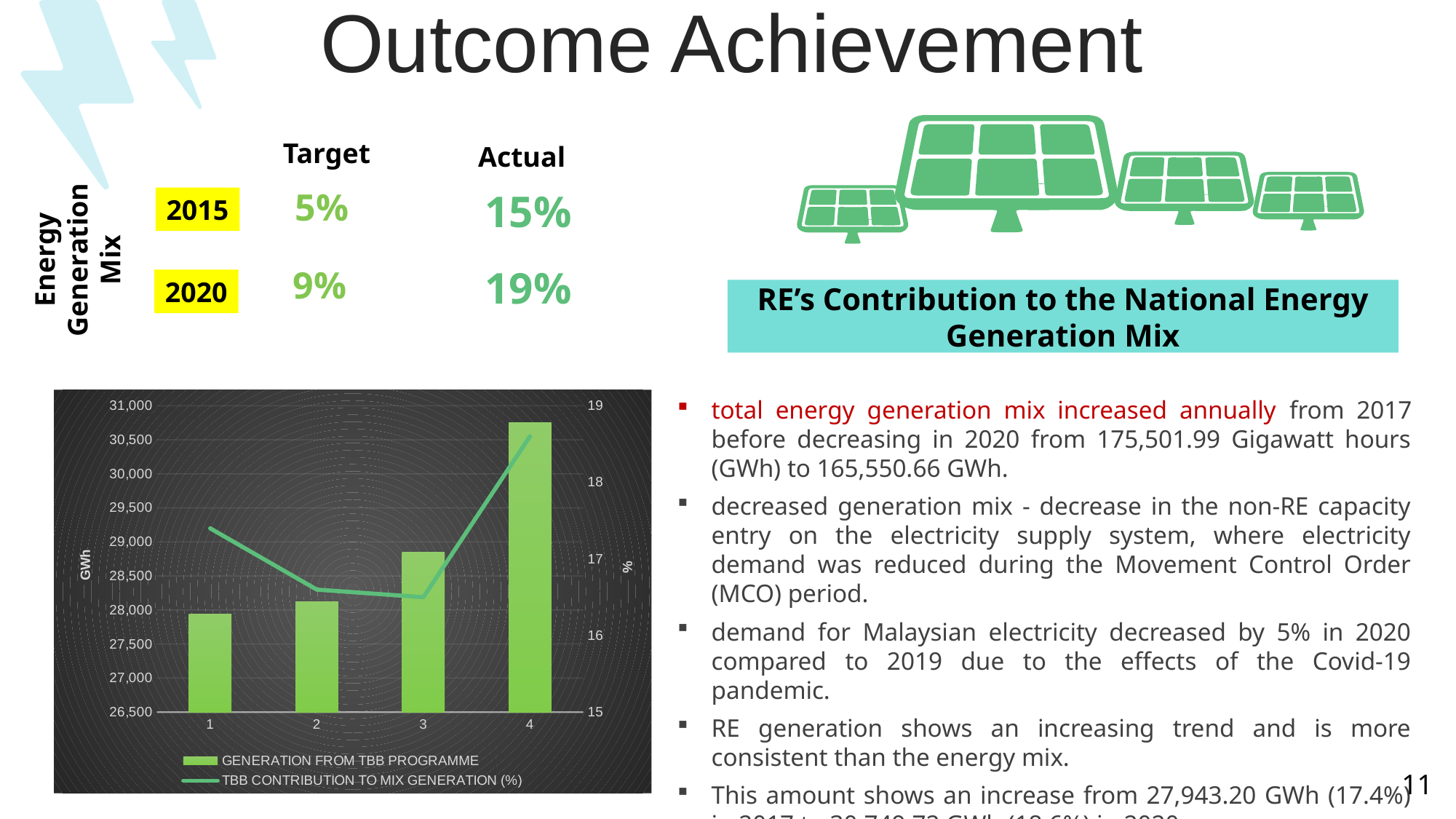
Which category has the lowest bar for GENERATION FROM TBB PROGRAMME? 1 Which category has the highest bar for GENERATION FROM TBB PROGRAMME? 4 What unit is labelled on the left vertical axis of the chart? GWh Is the TBB CONTRIBUTION TO MIX GENERATION (%) value for category 2 greater or less than 17? less How many series does the chart legend list? 2 Is the GENERATION FROM TBB PROGRAMME bar for category 4 greater or less than 30,500? greater How many categories are shown on the x axis of the chart? 4 Is the GENERATION FROM TBB PROGRAMME bar for category 1 greater or less than 28,000? less What kind of chart is used to show GENERATION FROM TBB PROGRAMME? bar chart Do the GENERATION FROM TBB PROGRAMME bars rise or fall from category 1 to category 4? rise Which is larger, the GENERATION FROM TBB PROGRAMME bar for category 3 or for category 2? category 3